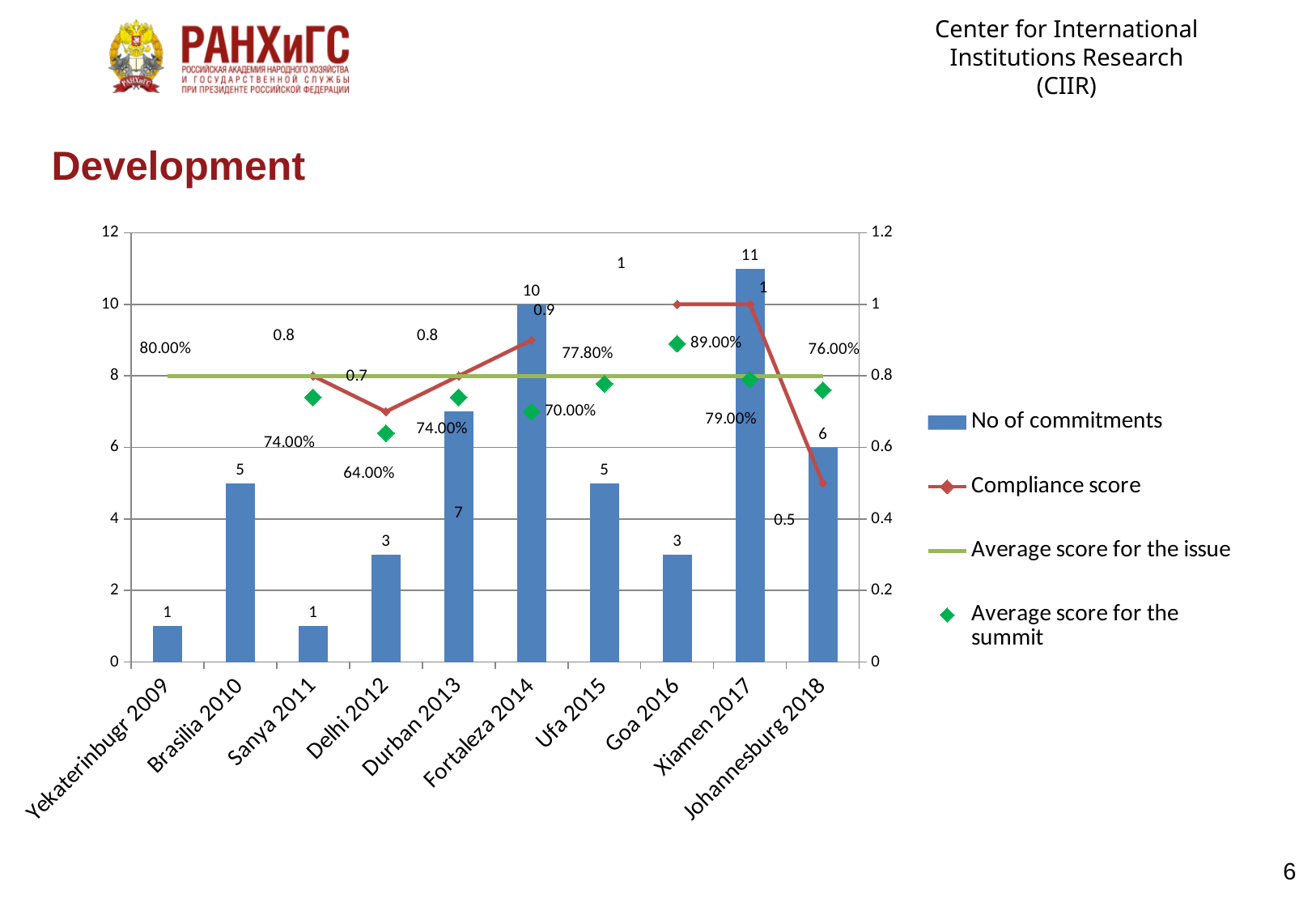
What is the number of commitments for Xiamen 2017? 11 How many summits (categories) are shown on the x axis of the chart? 10 What is the compliance score for Johannesburg 2018? 0.5 What kind of chart is shown on the slide? A combined bar and line chart Which summit has the highest number of commitments? Xiamen 2017 Which summit has the lowest average score for the summit? Delhi 2012 Which has more commitments, Brasilia 2010 or Johannesburg 2018? Johannesburg 2018 What is the difference in the number of commitments between Fortaleza 2014 and Durban 2013? 3 How many series does the chart's legend list? 4 What is the average score for the summit at Goa 2016? 89.00% What is the compliance score for Delhi 2012? 0.7 What is the title of the slide containing the chart? Development